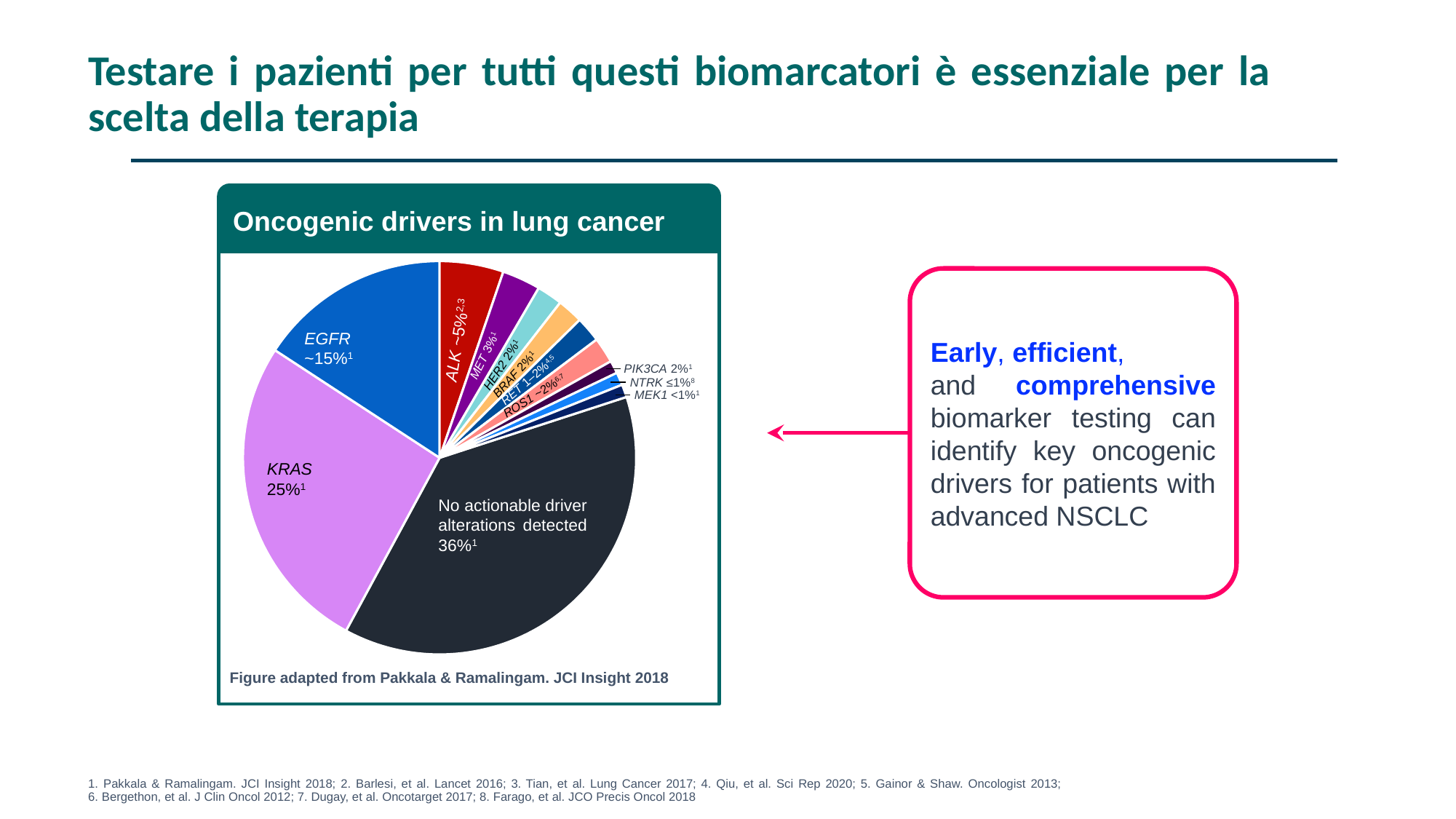
Which is larger, the KRAS slice or the EGFR slice? KRAS What percentage is shown for ALK? ~5% What percentage is shown for EGFR? ~15% What percentage is shown for KRAS? 25% What is the difference in percentage points between 'No actionable driver alterations detected' and KRAS? 11 How many slices does the pie chart have? 12 What kind of chart is shown on the slide? pie chart What percentage is shown for PIK3CA? 2% What percentage is shown for 'No actionable driver alterations detected'? 36% What percentage is shown for MET? 3% What is the title of the chart? Oncogenic drivers in lung cancer Which slice of the pie is the largest? No actionable driver alterations detected